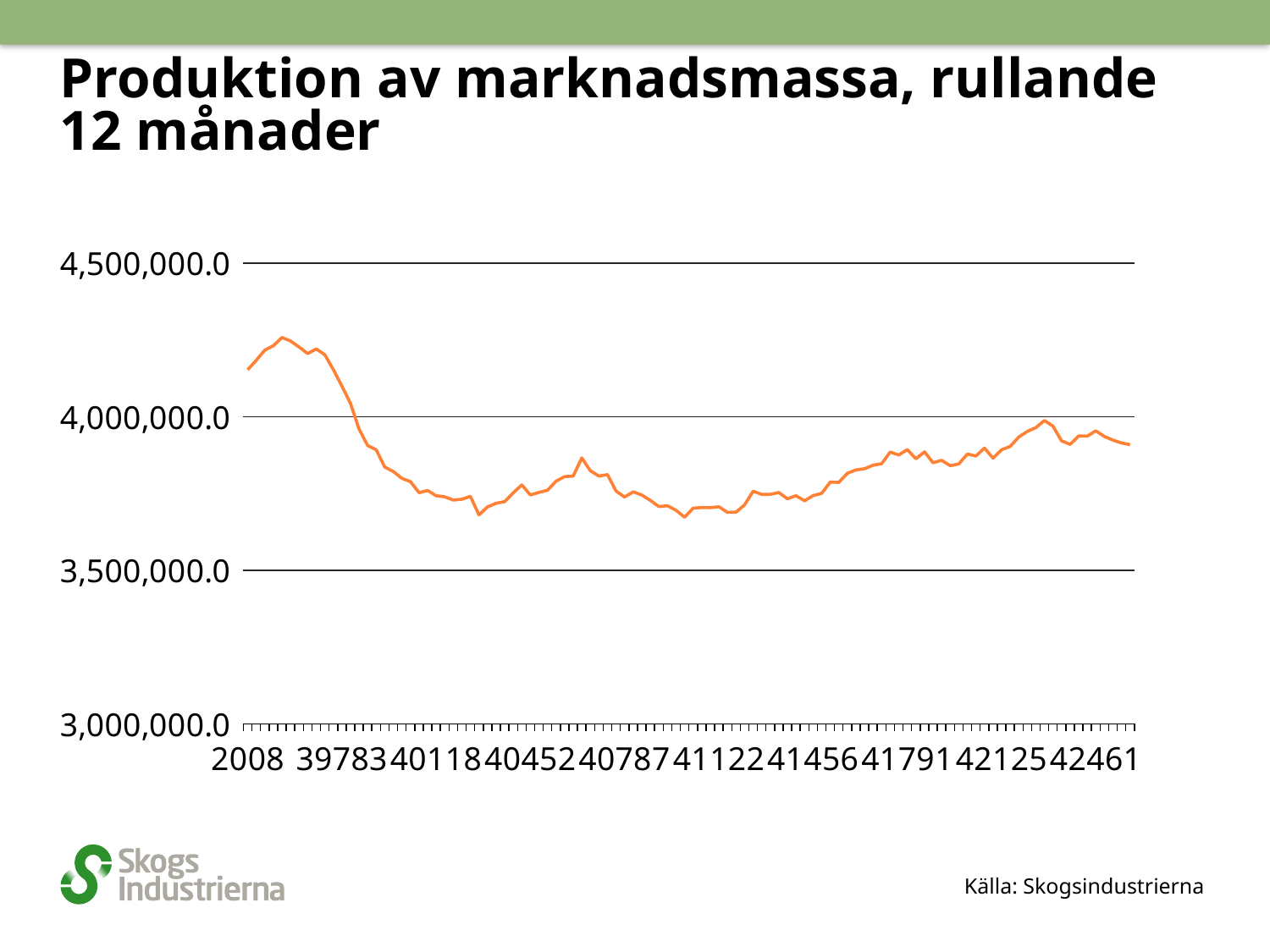
Overall, from the first point to the last point, does the line rise or fall? fall What source is cited for the chart? Källa: Skogsindustrierna What is the title of the chart? Produktion av marknadsmassa, rullande 12 månader How many data series are plotted in the chart? 1 Is the value at the end of the series (42461) greater or less than 4,000,000.0? less Is the highest point of the line greater or less than 4,500,000.0? less What kind of chart is shown on the slide? line chart Is the value at 41122 greater or less than 4,000,000.0? less Does the line reach its highest value near the beginning or near the end of the x axis? near the beginning